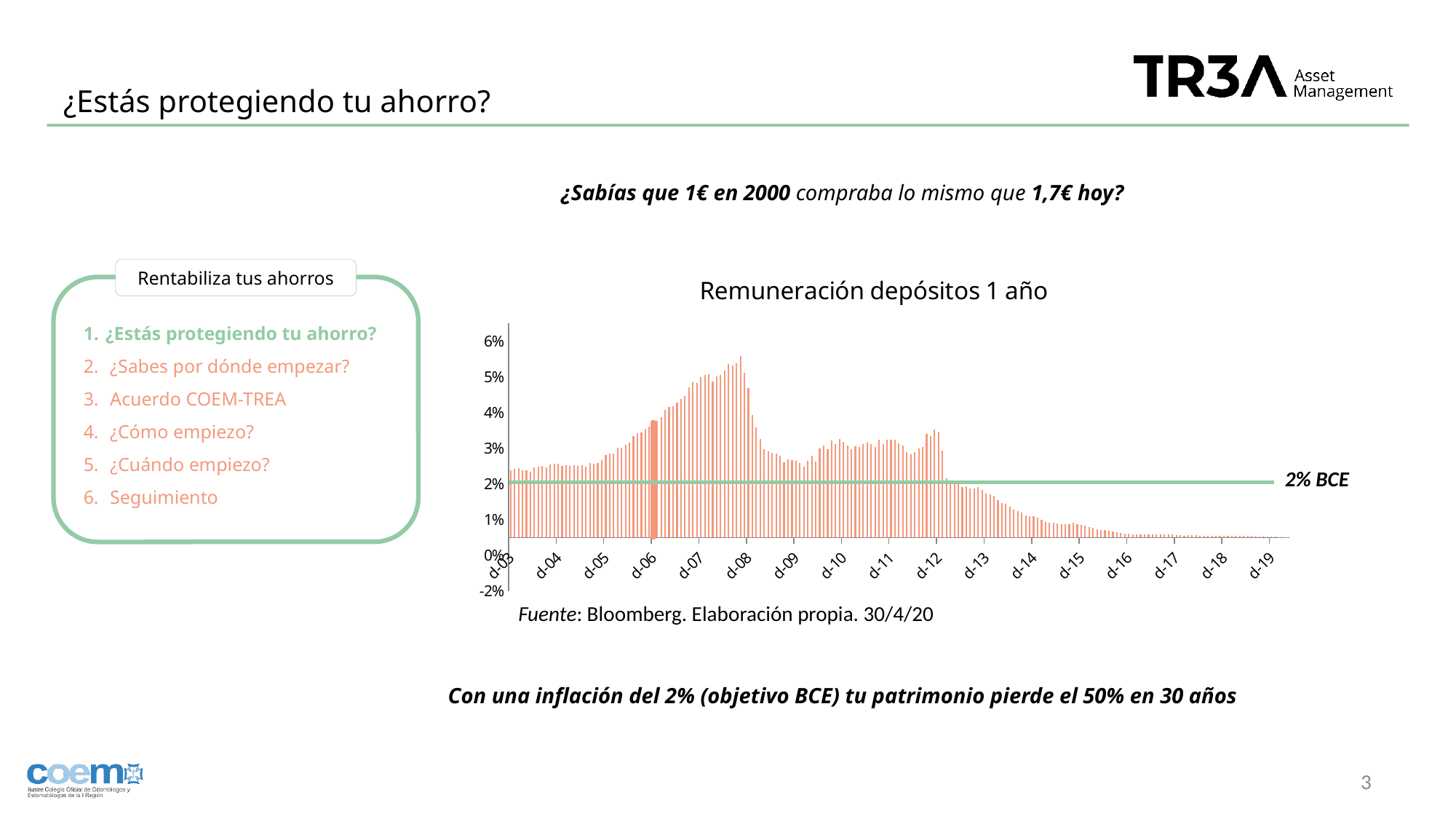
What is the title of the chart? Remuneración depósitos 1 año Is the value of the bars around d-15 greater or less than 1%? less How many date labels are shown on the x axis? 17 Which is larger, the value around d-06 or the value around d-04? d-06 Is the value of the bars around d-10 greater or less than 2%? greater What label is shown next to the green horizontal line on the chart? 2% BCE Do the bar values rise or fall from d-12 to d-19? fall What kind of chart is used to show the deposit remuneration? Bar chart Is the value of the bars around d-08 greater or less than 5%? greater Around which x-axis label do the bars reach their highest value? d-08 At what level is the green horizontal reference line drawn? 2%